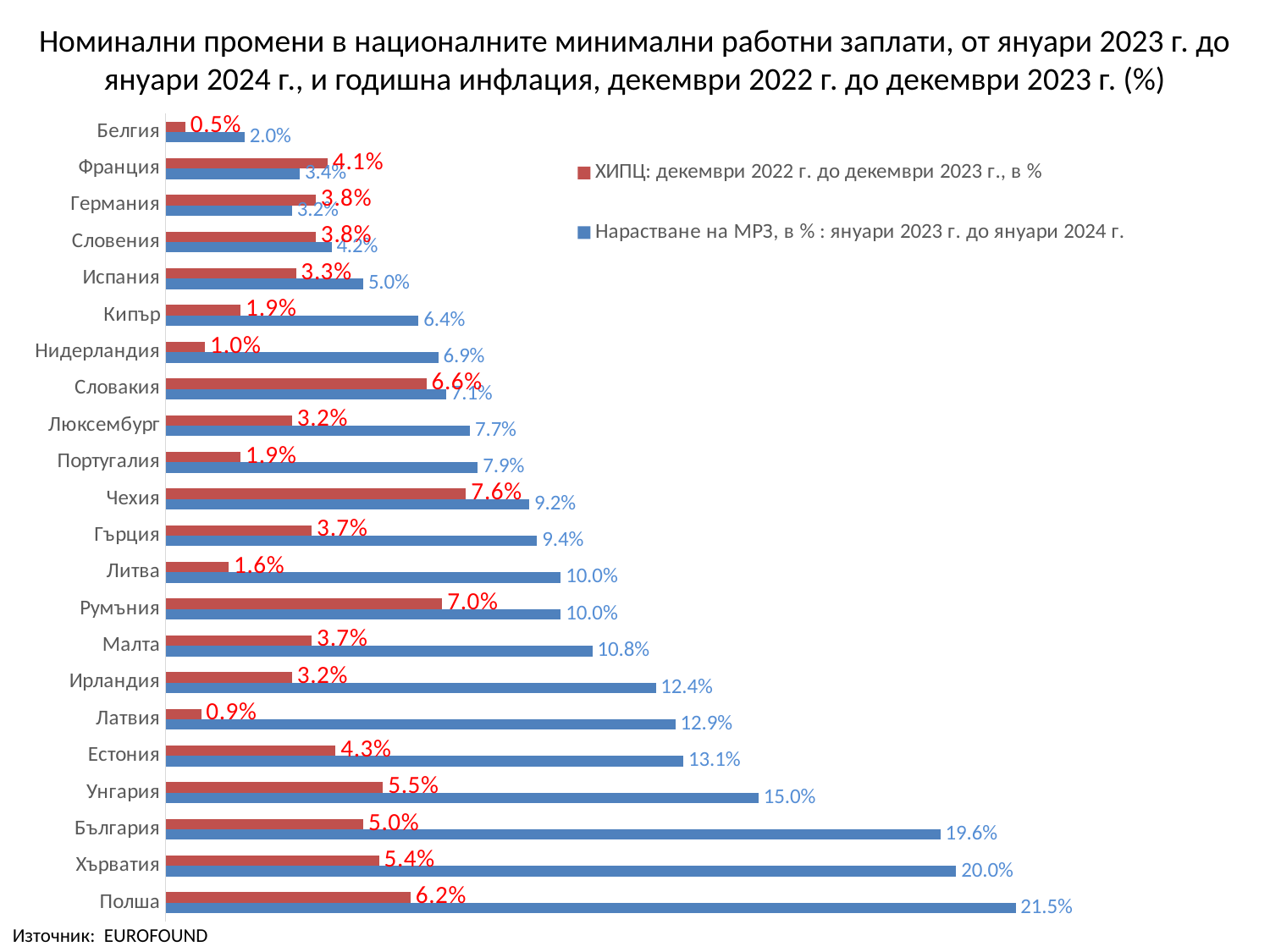
Which country has the highest Нарастване на МРЗ value? Полша What is the ХИПЦ value for Чехия? 7.6% What is the source cited at the bottom of the slide? EUROFOUND What is the value of Нарастване на МРЗ for Полша? 21.5% How many series does the legend list? 2 Which is larger for Франция: the ХИПЦ value or the Нарастване на МРЗ value? ХИПЦ What is the difference between the Нарастване на МРЗ values for Хърватия and България? 0.4% Which country has the lowest ХИПЦ value? Белгия What kind of chart is shown on the slide? Bar chart What is the difference between the ХИПЦ value and the Нарастване на МРЗ value for Латвия? 12.0% How many countries are shown on the chart? 22 Which colour represents the ХИПЦ series in the chart? Red